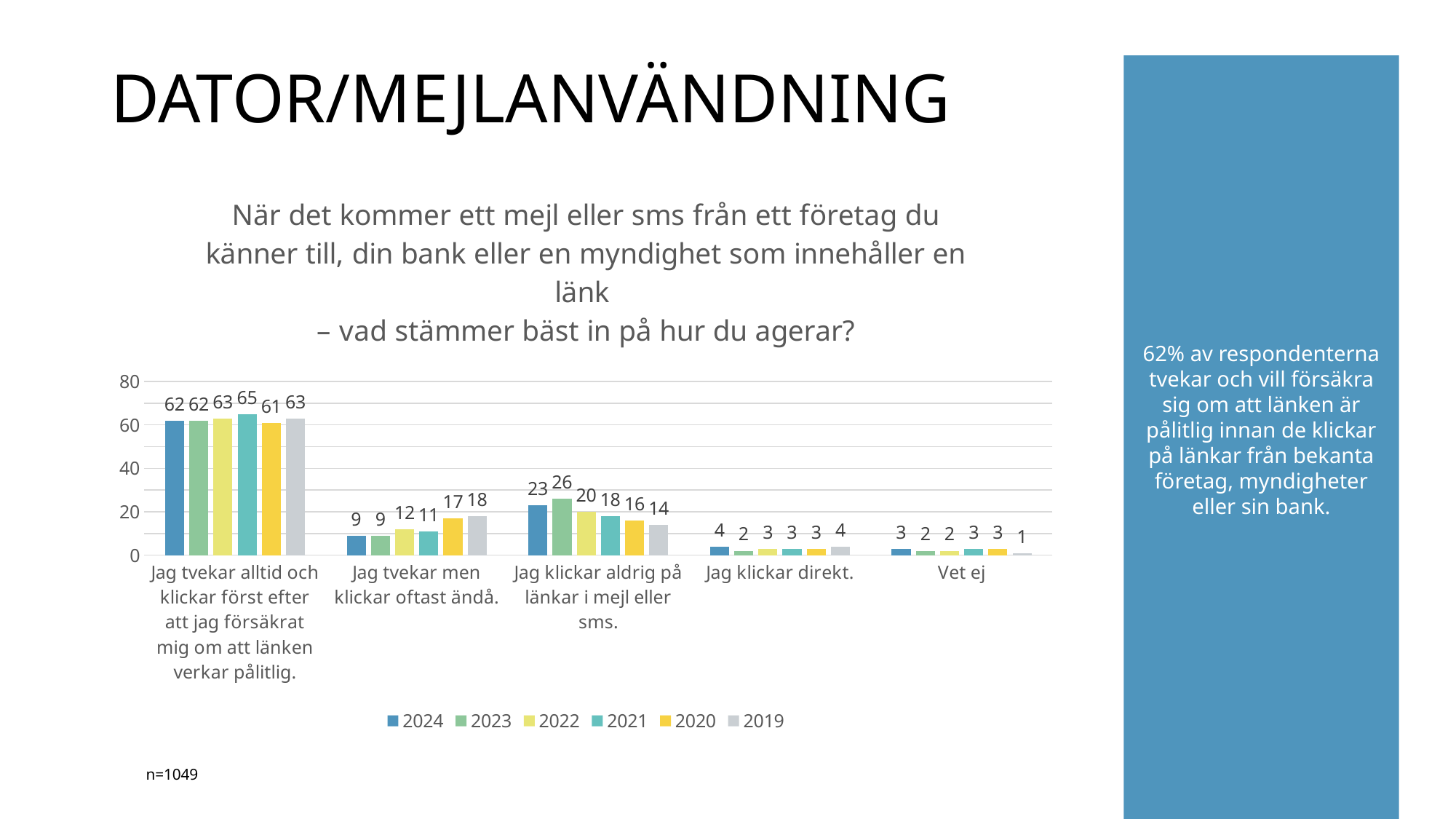
Is the value for 2020 in the category "Jag tvekar alltid och klickar först efter att jag försäkrat mig om att länken verkar pålitlig." greater or less than 40? greater What type of chart is shown on the slide? bar chart What is the value for 2021 in the category "Jag tvekar alltid och klickar först efter att jag försäkrat mig om att länken verkar pålitlig."? 65 How many series does the legend list? 6 Which year has the highest value in the category "Jag klickar aldrig på länkar i mejl eller sms."? 2023 Which year has the lowest value in the category "Vet ej"? 2019 What is the difference between the 2019 and 2024 values in the category "Jag tvekar men klickar oftast ändå."? 9 How many categories are shown on the x axis? 5 Which year is listed first in the legend? 2024 In the category "Jag klickar aldrig på länkar i mejl eller sms.", which is larger: the value for 2022 or the value for 2019? 2022 What is the value for 2019 in the category "Jag tvekar men klickar oftast ändå."? 18 What is the value for 2024 in the category "Jag klickar aldrig på länkar i mejl eller sms."? 23